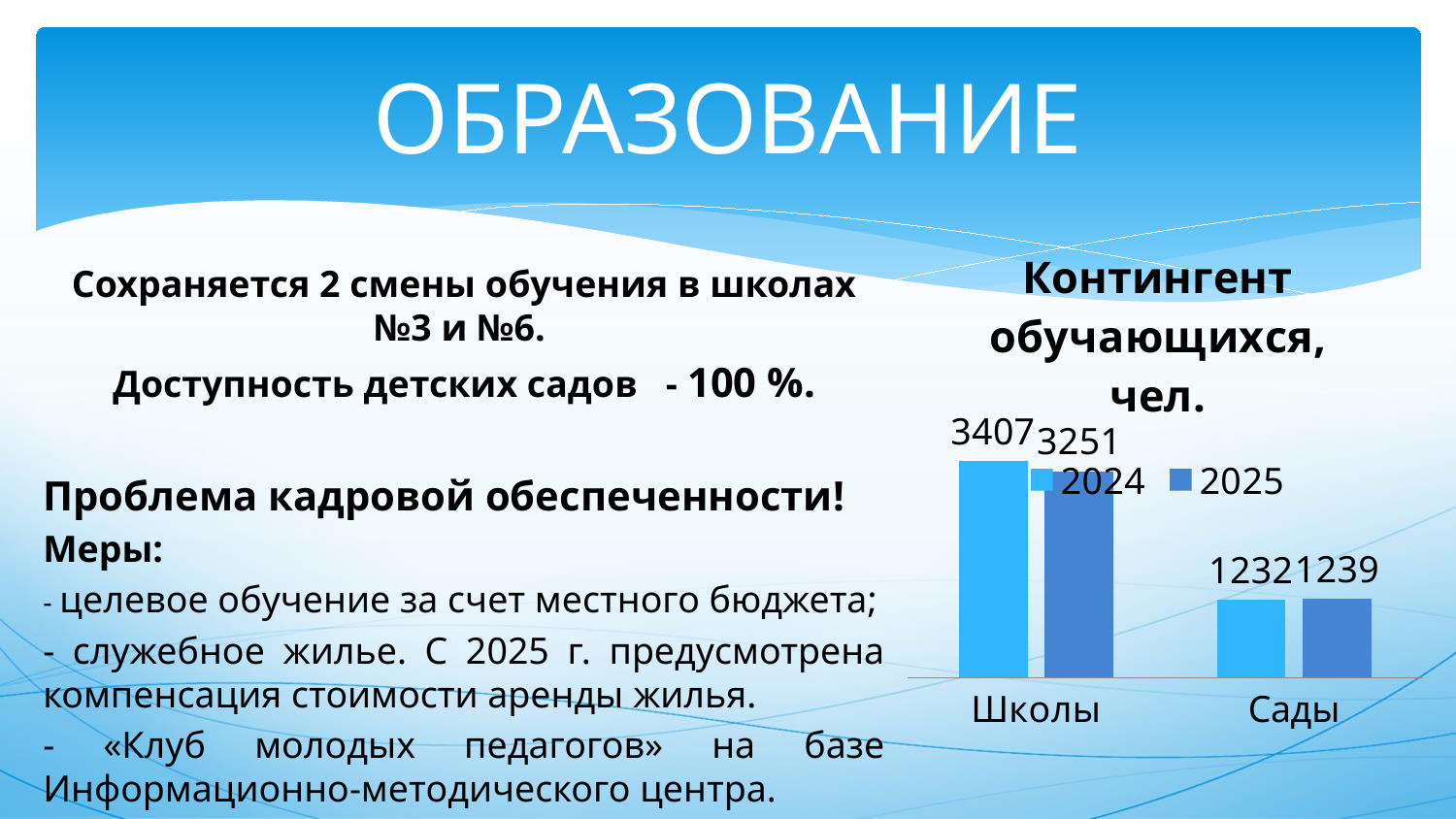
What is the difference between the 2025 and 2024 values for Сады? 7 Which is larger for Школы: the 2024 value or the 2025 value? 2024 Which category has the highest value in the 2024 series? Школы How many categories are shown on the x axis of the chart? 2 What is the difference between the 2024 and 2025 values for Школы? 156 What is the value for Сады in the 2025 series? 1239 What is the value for Сады in the 2024 series? 1232 What type of chart is shown on the slide? Bar chart What is the value for Школы in the 2024 series? 3407 Which category has the lowest value in the 2025 series? Сады How many series does the chart legend list? 2 What is the value for Школы in the 2025 series? 3251